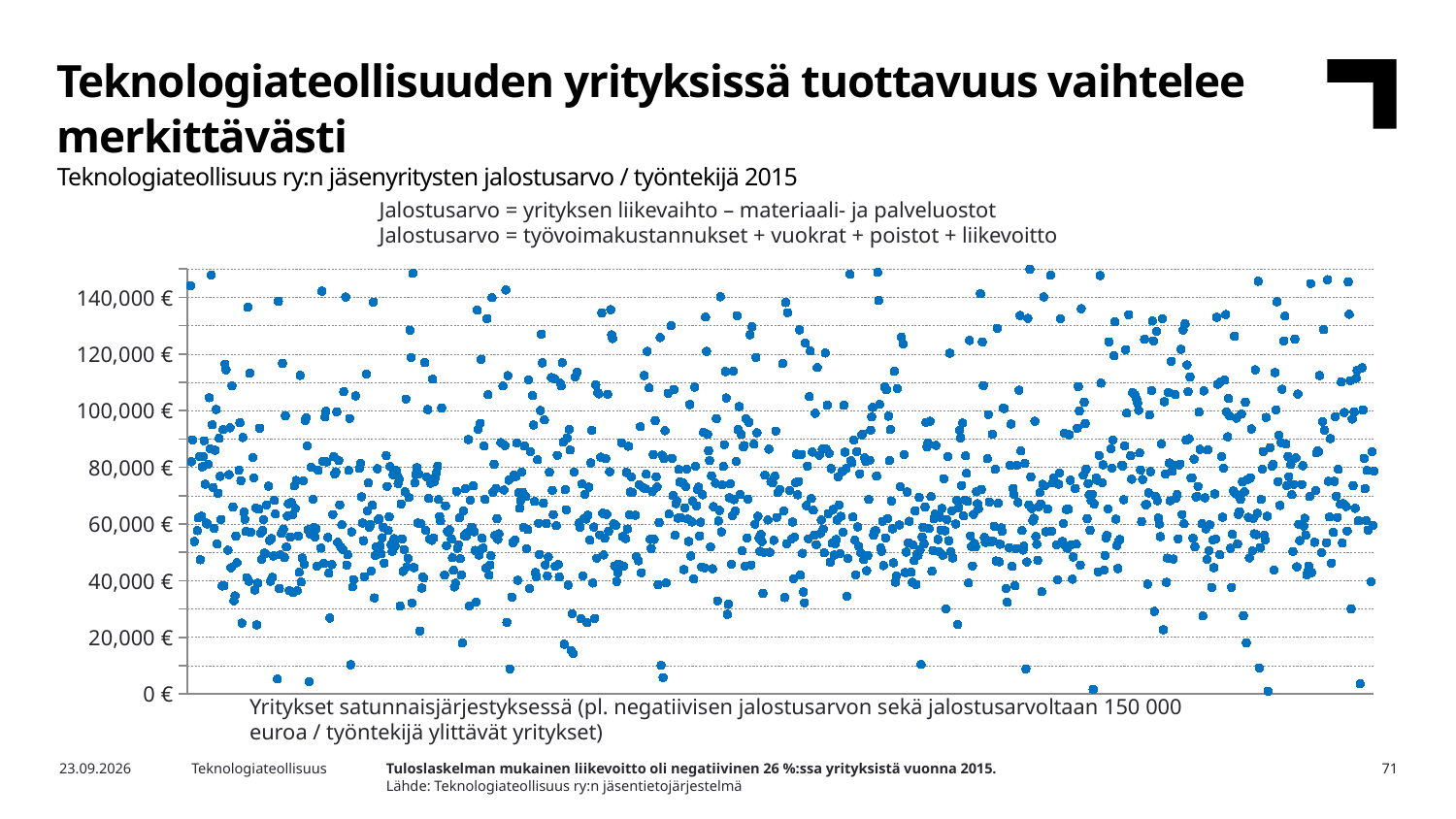
Are there any plotted points below the 20,000 € line on the y axis? yes What kind of chart is shown on the slide? scatter chart Which year does the chart's data refer to, according to the chart title? 2015 What is the highest labelled tick on the y axis of the chart? 140,000 € Are most of the plotted points above or below 100,000 € on the y axis? below What is the lowest labelled tick on the y axis of the chart? 0 €